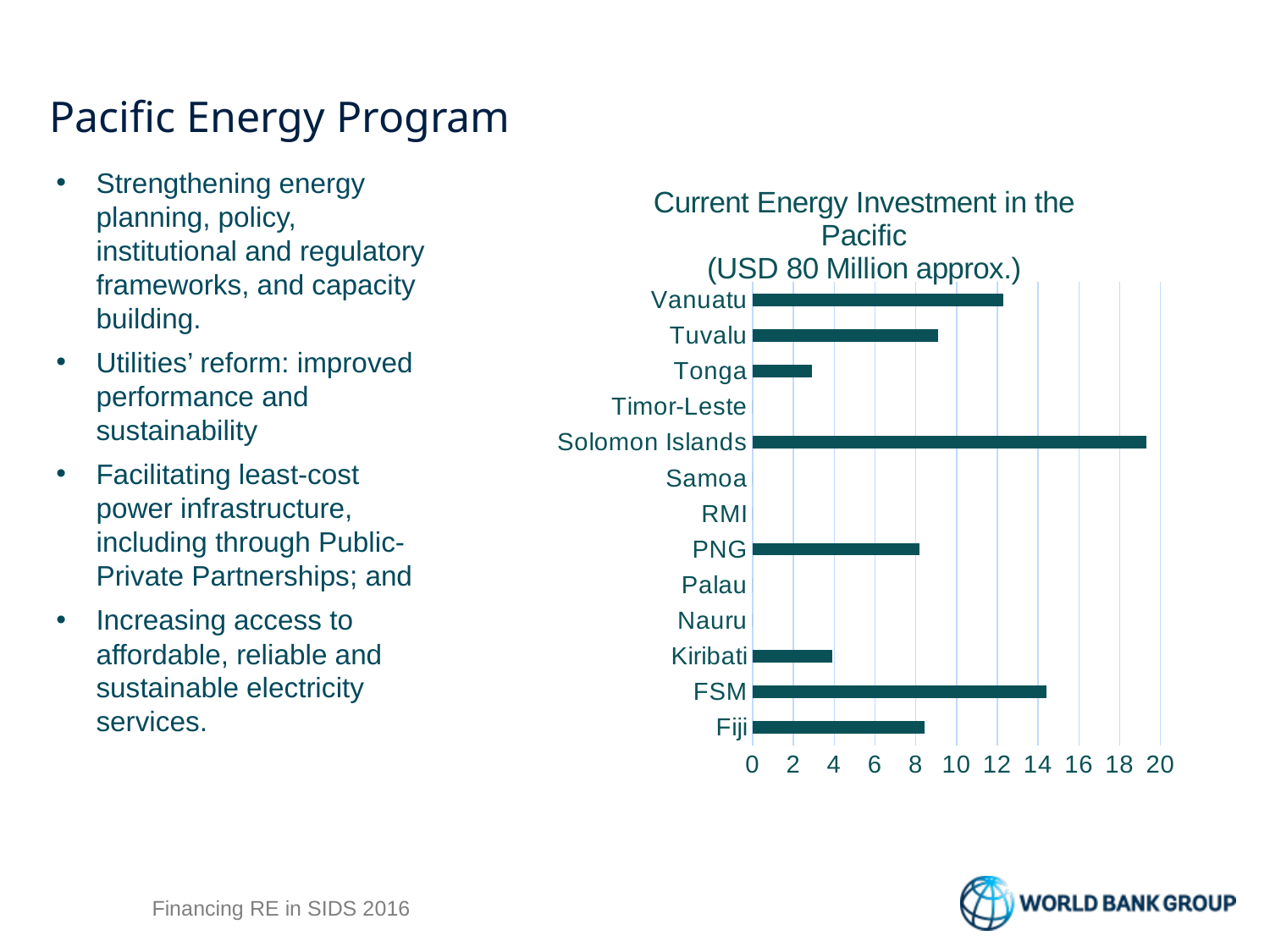
How many countries on the chart show no visible bar? 5 Which has a larger value, FSM or Vanuatu? FSM Is the value for Kiribati greater or less than 2? greater How many countries are listed on the chart's vertical axis? 13 Which has a larger value, Tuvalu or Tonga? Tuvalu Is the value for Solomon Islands greater or less than 18? greater Is the value for Tonga greater or less than 4? less What kind of chart is shown on the slide? Bar chart Which country has the highest current energy investment in the chart? Solomon Islands What is the title of the chart? Current Energy Investment in the Pacific (USD 80 Million approx.)